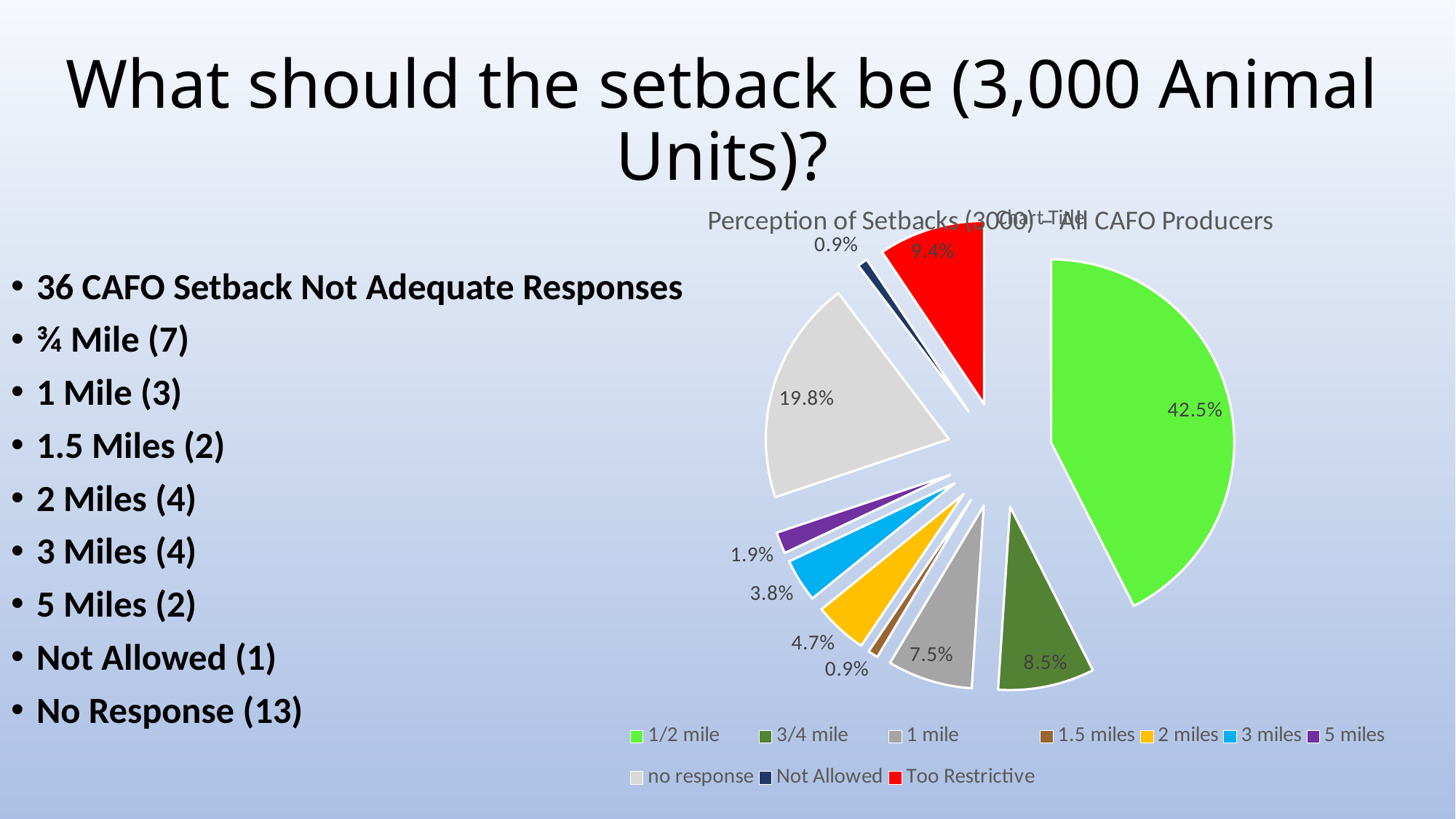
What percentage is shown for the 2 miles slice? 4.7% What is the difference in percentage points between the 1/2 mile slice and the no response slice? 22.7 What percentage is shown for the 3/4 mile slice? 8.5% What percentage is shown for the Too Restrictive slice? 9.4% Which category has the largest slice of the pie? 1/2 mile What percentage is shown for the no response slice? 19.8% What type of chart is shown on the slide? pie chart What is the difference in percentage points between the 3 miles slice and the 5 miles slice? 1.9 Which is larger, the 1 mile slice or the 3/4 mile slice? 3/4 mile How many slices does the pie chart have? 10 What colour is the Too Restrictive slice in the pie chart? red What percentage of the pie is the 1/2 mile slice? 42.5%